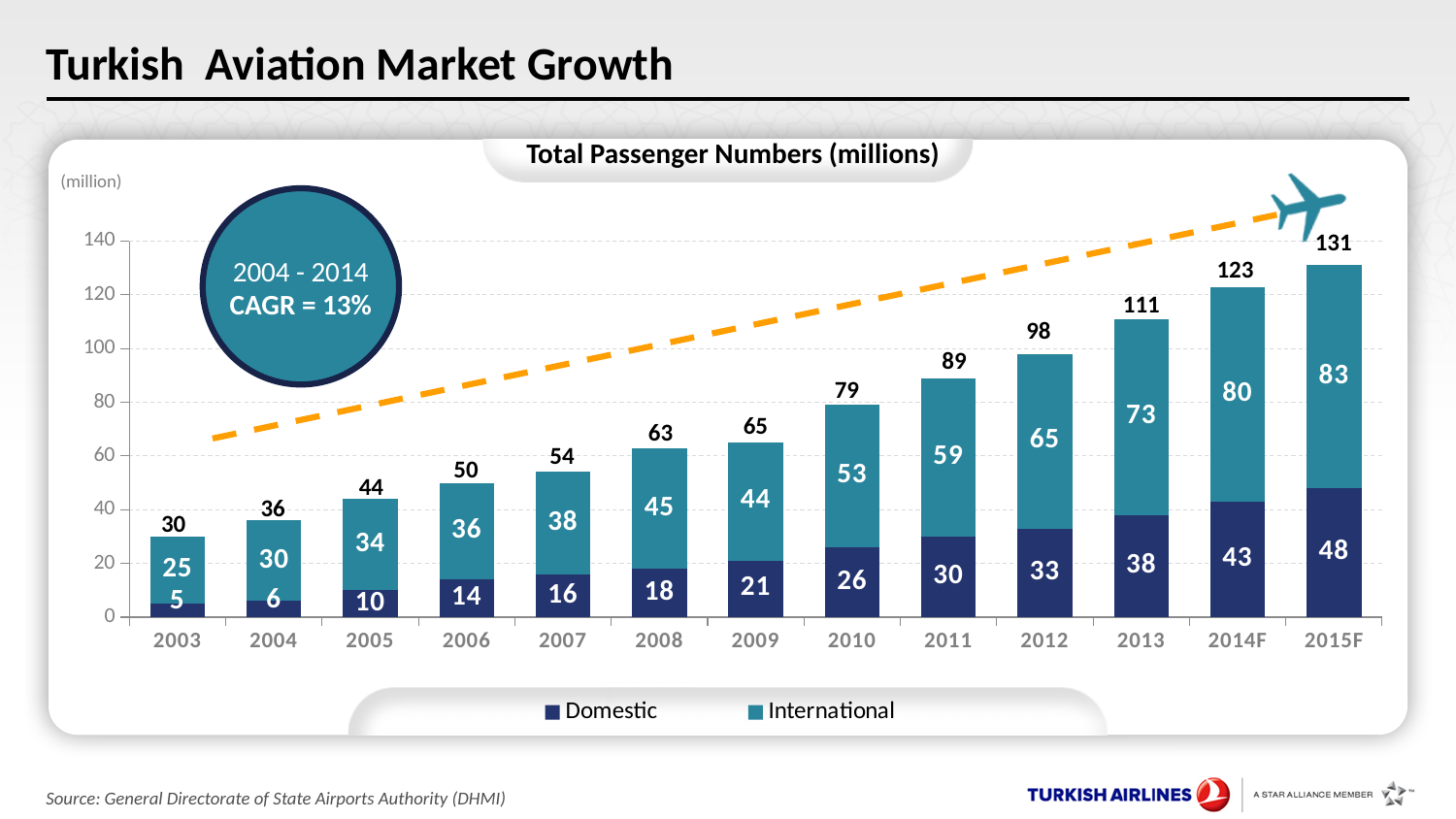
Do the total passenger numbers rise or fall from 2003 to 2015F? Rise Which year has the lowest Domestic passenger value? 2003 What is the difference between the total passenger numbers for 2014F and 2013? 12 Which is larger, the International value for 2009 or the International value for 2008? 2008 What CAGR is stated in the circle on the chart for 2004 - 2014? 13% What is the Domestic passenger value for 2010? 26 What is the International passenger value for 2013? 73 What is the total passenger number shown for 2008? 63 What kind of chart is shown on the slide? Stacked bar chart How many years are shown on the x axis? 13 Which year has the highest total passenger number? 2015F How many series does the legend list? 2